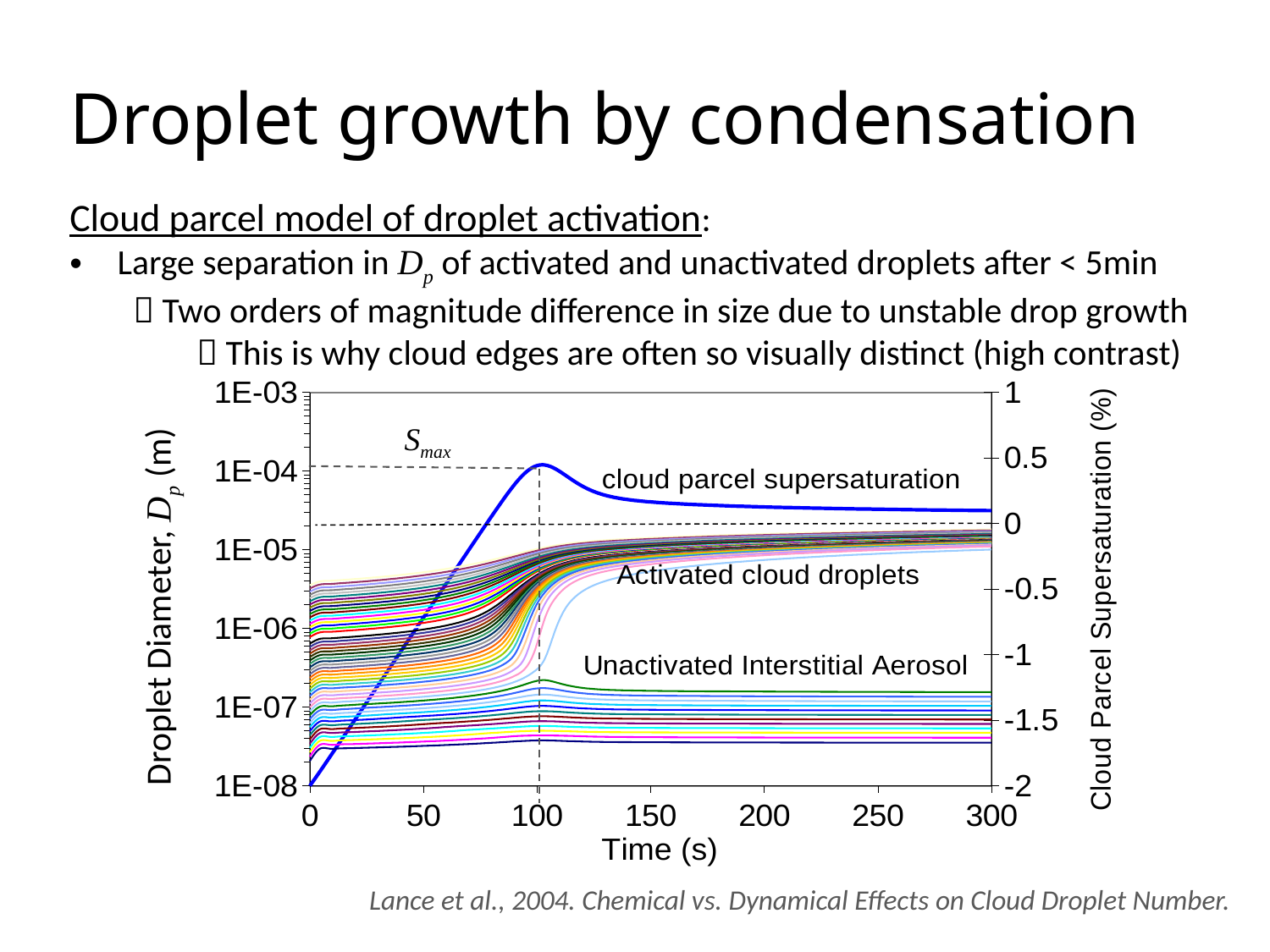
What is the label of the x axis? Time (s) Is the peak value of the cloud parcel supersaturation greater or less than 0? greater What is the label of the right-hand y axis? Cloud Parcel Supersaturation (%) Is the peak value of the cloud parcel supersaturation greater or less than 1? less Does the cloud parcel supersaturation rise or fall between 0 s and 100 s? rise Does the cloud parcel supersaturation rise or fall between 100 s and 300 s? fall At what time on the x axis does the cloud parcel supersaturation reach its maximum (S_max), as marked by the dashed vertical line? 100 At 300 s, are the diameters of the unactivated interstitial aerosol greater or less than 1E-06 m? less Which group has larger droplet diameters at 300 s, the activated cloud droplets or the unactivated interstitial aerosol? Activated cloud droplets What kind of chart is shown on the slide? line chart